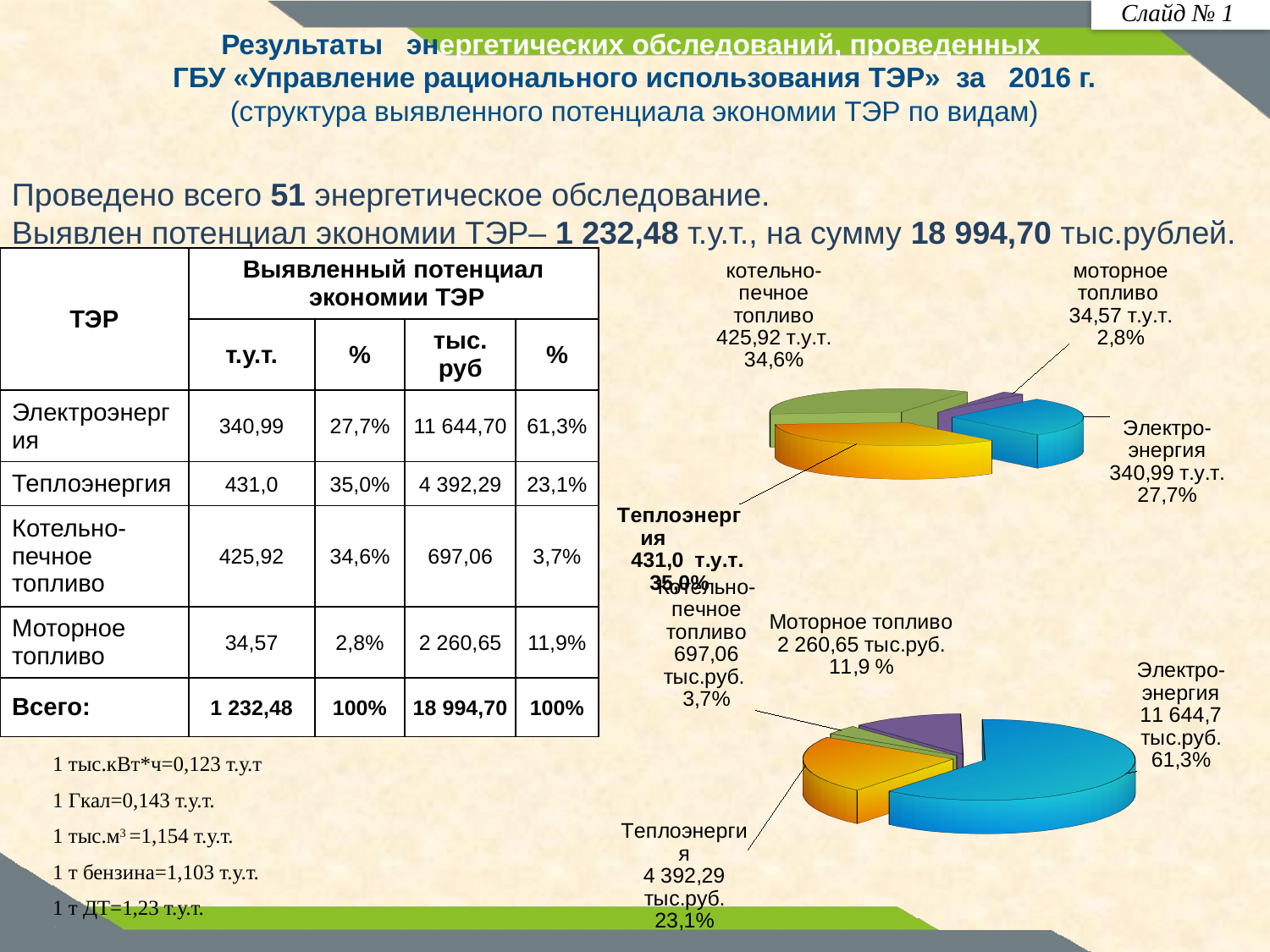
In the bottom pie chart (тыс.руб.), what share does Моторное топливо have? 11,9 % How many slices does the bottom pie chart (тыс.руб.) have? 4 In the bottom pie chart (тыс.руб.), what is the value for Теплоэнергия? 4 392,29 тыс.руб. In the bottom pie chart (тыс.руб.), what is the value for Электроэнергия? 11 644,7 тыс.руб. In the bottom pie chart (тыс.руб.), which category has the largest slice? Электроэнергия In the bottom pie chart (тыс.руб.), which is larger: Котельно-печное топливо or Моторное топливо? Моторное топливо In the top pie chart (т.у.т.), what share does Теплоэнергия have? 35,0% In the top pie chart (т.у.т.), what is the value for Электроэнергия? 340,99 т.у.т. In the top pie chart (т.у.т.), what share does моторное топливо have? 2,8% In the top pie chart (т.у.т.), which category has the smallest slice? моторное топливо In the top pie chart (т.у.т.), what is the value for котельно-печное топливо? 425,92 т.у.т. What type of charts are shown on the slide? pie charts